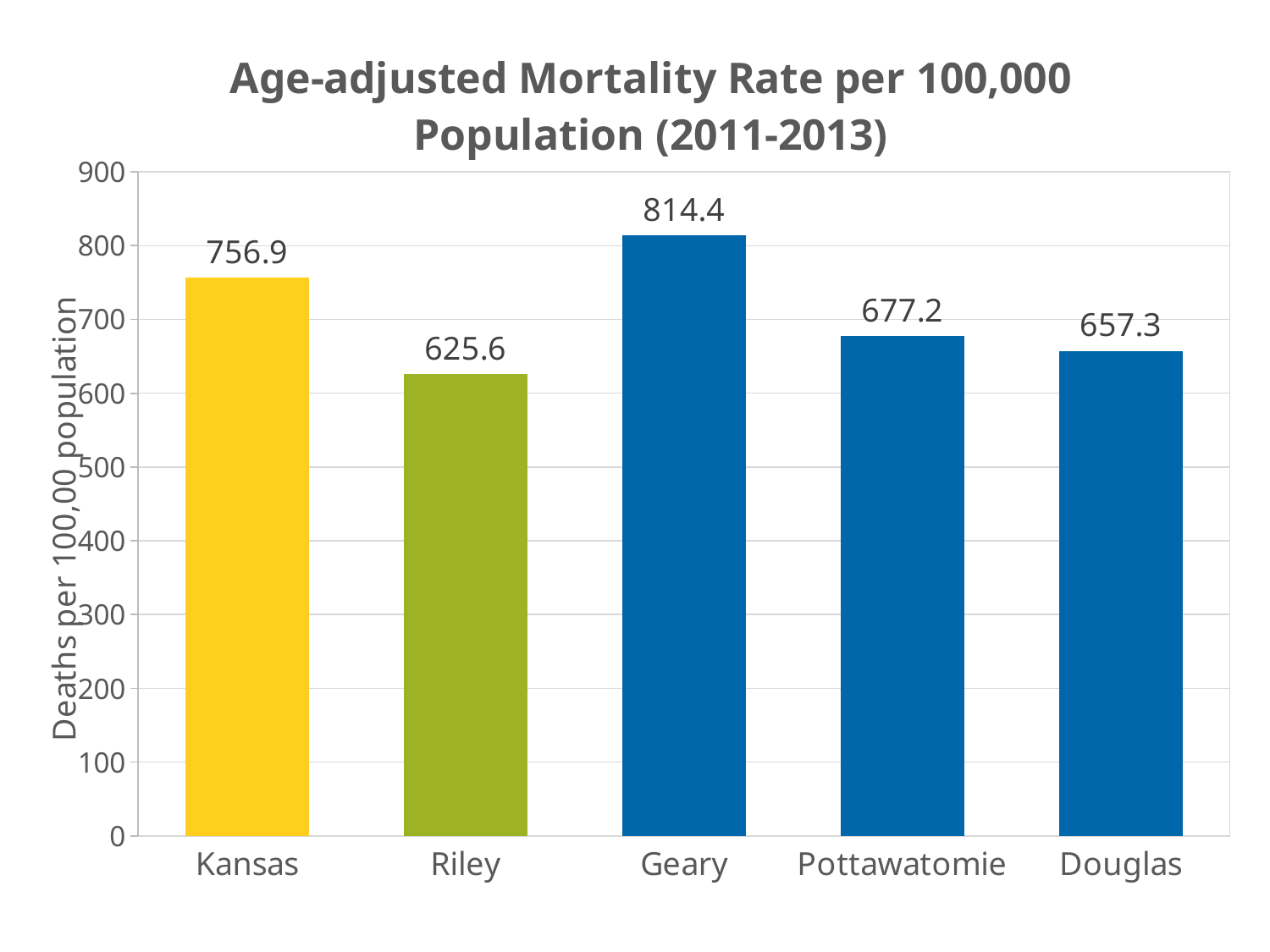
What is the age-adjusted mortality rate for Riley? 625.6 Which category has the highest mortality rate? Geary Is the value for Geary greater or less than 800? greater What is the age-adjusted mortality rate for Kansas? 756.9 What kind of chart is shown on the slide? Bar chart What is the label of the vertical axis? Deaths per 100,00 population What is the difference between the mortality rates of Kansas and Douglas? 99.6 How many categories are shown on the x axis? 5 Which category has the lowest mortality rate? Riley Which has a higher mortality rate, Pottawatomie or Douglas? Pottawatomie What is the age-adjusted mortality rate for Pottawatomie? 677.2 What is the difference between the mortality rates of Geary and Riley? 188.8